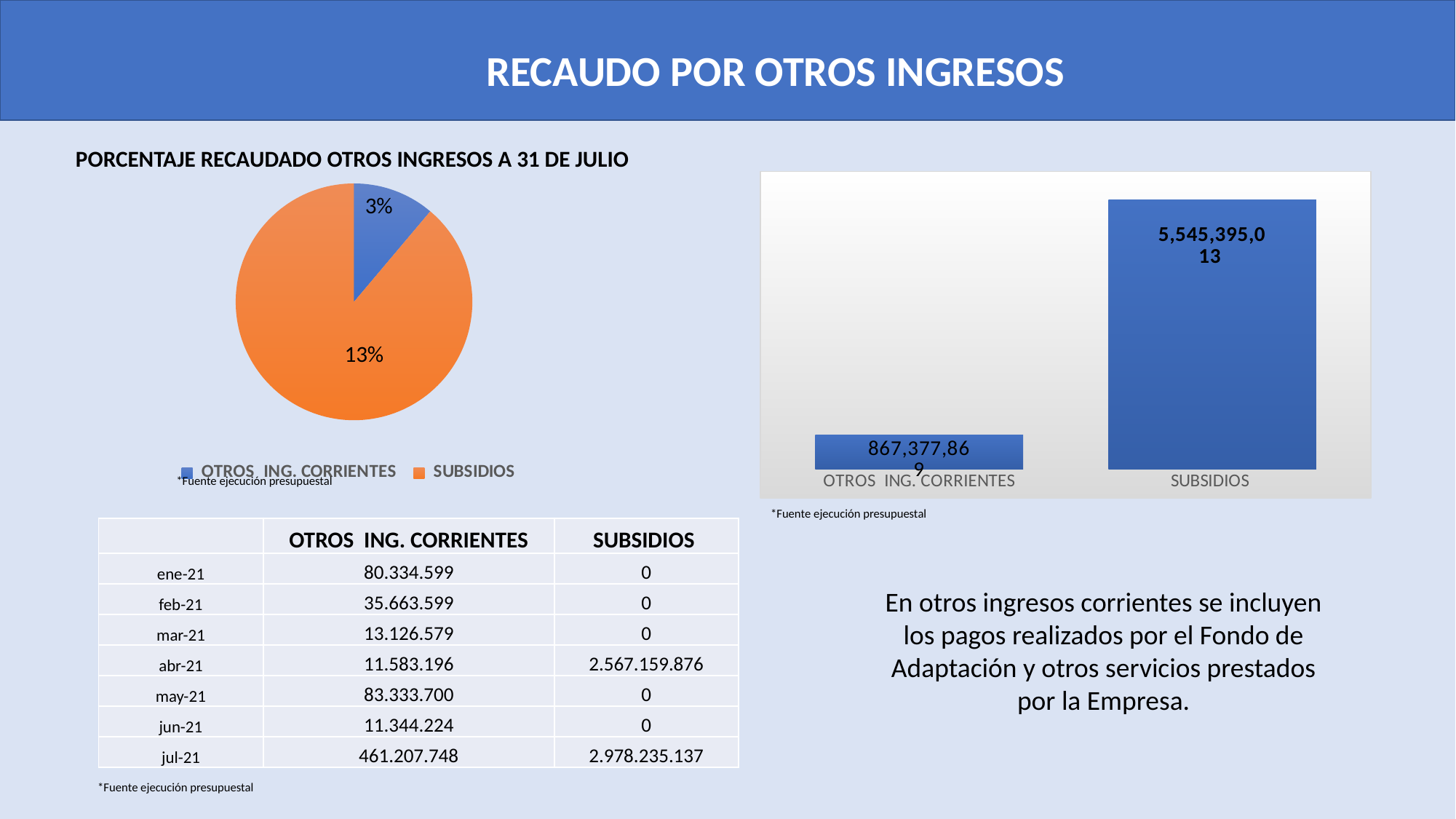
In the pie chart titled 'PORCENTAJE RECAUDADO OTROS INGRESOS A 31 DE JULIO', what percentage is shown for OTROS ING. CORRIENTES? 3% In the pie chart on the left, which category has the larger slice? SUBSIDIOS In the pie chart titled 'PORCENTAJE RECAUDADO OTROS INGRESOS A 31 DE JULIO', what percentage is shown for SUBSIDIOS? 13% How many entries does the legend of the pie chart on the left list? 2 In the bar chart on the right, which category has the highest value? SUBSIDIOS In the bar chart on the right, what is the value for OTROS ING. CORRIENTES? 867,377,869 In the bar chart on the right, what is the value for SUBSIDIOS? 5,545,395,013 In the bar chart on the right, is the value for SUBSIDIOS larger or smaller than the value for OTROS ING. CORRIENTES? Larger In the pie chart on the left, what colour is the SUBSIDIOS slice? Orange How many bars are shown in the bar chart on the right? 2 What kind of chart is shown on the right side of the slide? Bar chart In the pie chart on the left, which category has the smaller slice? OTROS ING. CORRIENTES